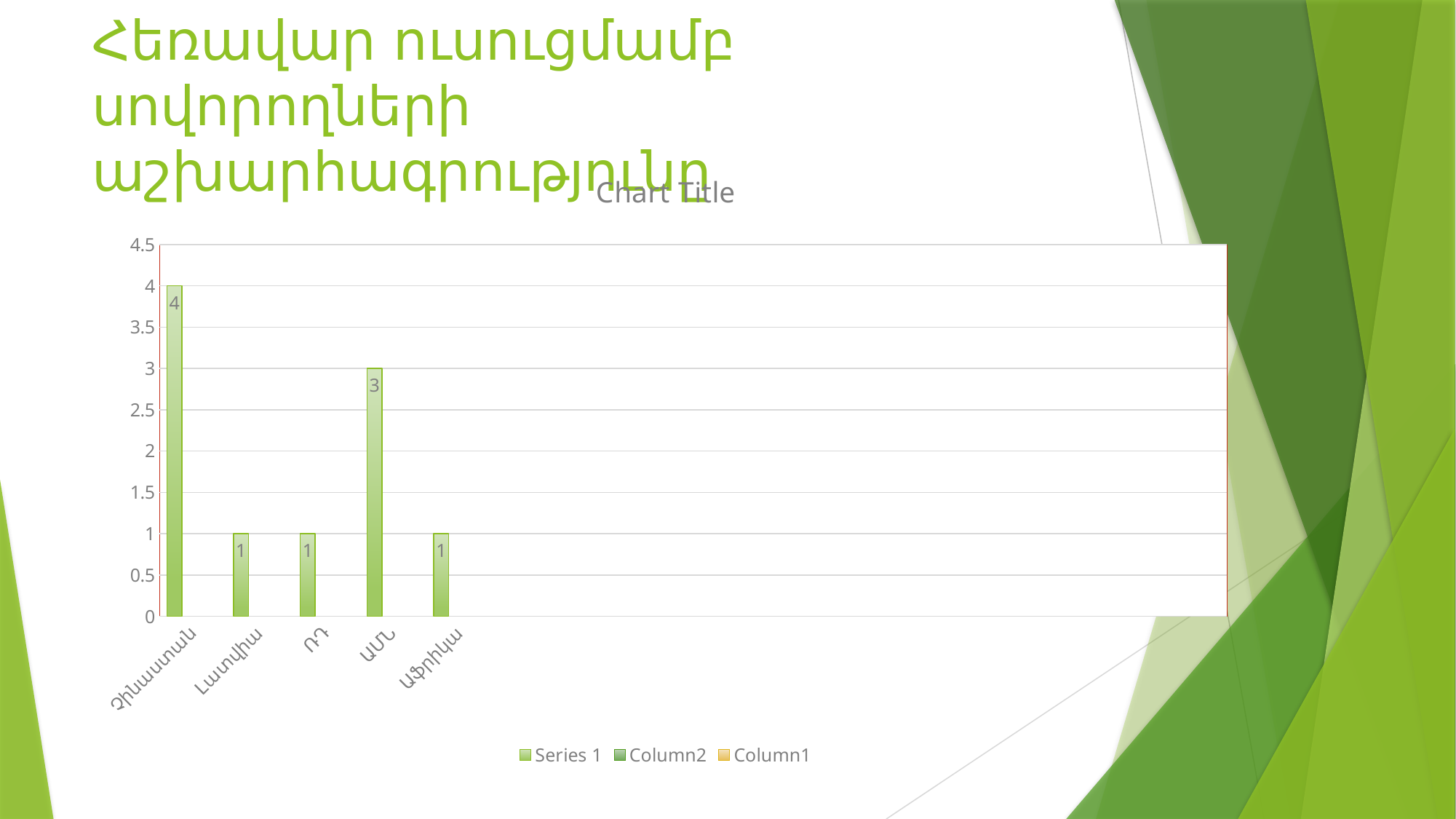
Which category has the highest value? Չինաստան Which is larger, the value for ԱՄՆ or the value for ՌԴ? ԱՄՆ How many categories are shown on the x axis? 5 What is the value for ԱՄՆ? 3 What is the difference between the values for ԱՄՆ and Աֆրիկա? 2 What is the title shown above the chart? Chart Title Is the value for Չինաստան greater or less than 3.5? greater What is the value for Չինաստան? 4 What is the difference between the values for Չինաստան and ԱՄՆ? 1 What kind of chart is shown on the slide? bar chart What is the value for Լատվիա? 1 How many series does the legend list? 3